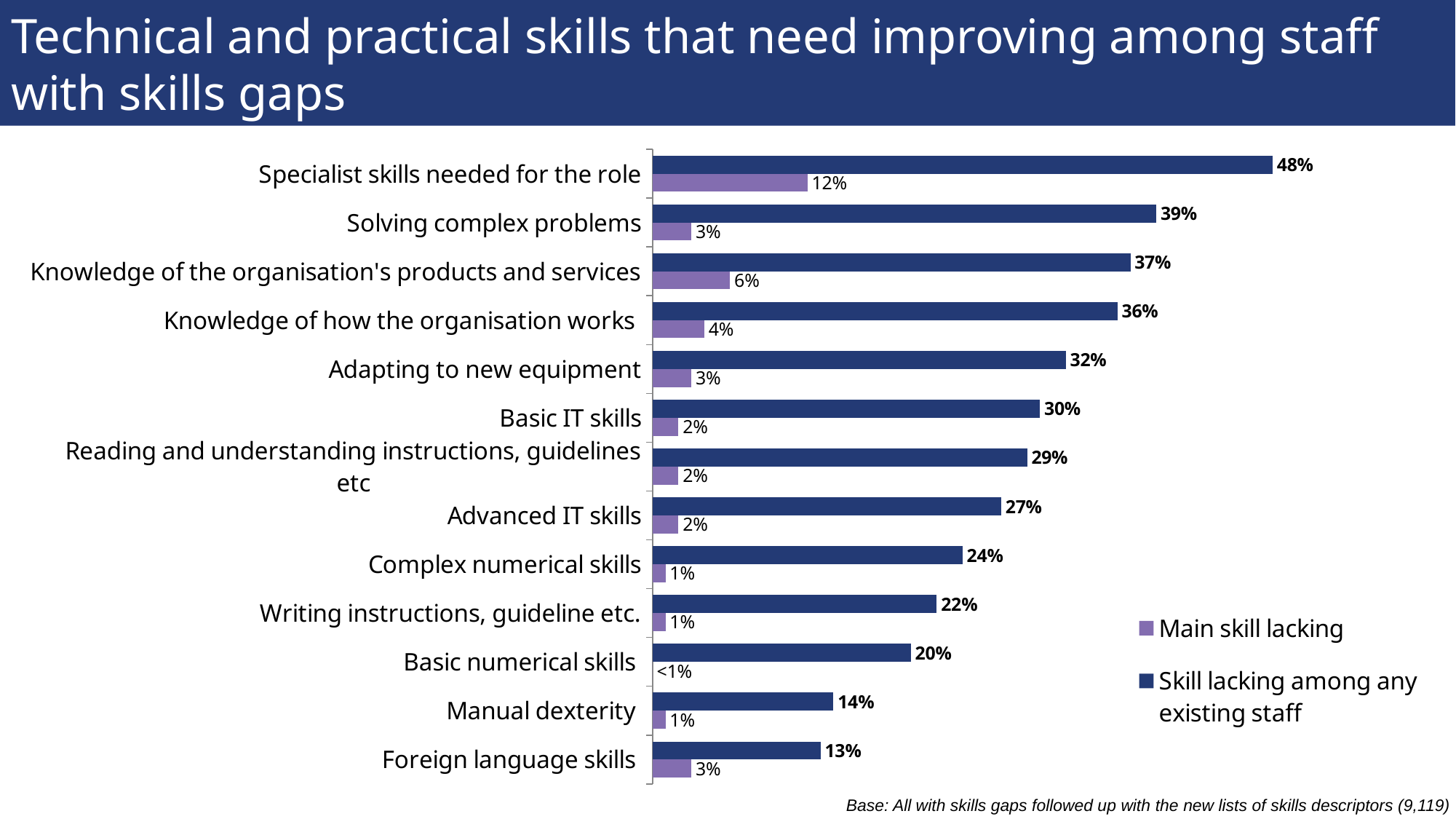
How many series does the legend list? 2 Which skill has the highest 'Main skill lacking' percentage? Specialist skills needed for the role How many skill categories are shown on the chart? 13 What is the 'Main skill lacking' value for Knowledge of the organisation's products and services? 6% Which is larger: the 'Skill lacking among any existing staff' value for Basic IT skills or for Advanced IT skills? Basic IT skills Which skill has the lowest 'Skill lacking among any existing staff' percentage? Foreign language skills What is the difference between the 'Skill lacking among any existing staff' values for Solving complex problems and Adapting to new equipment? 7% Which skill has the highest 'Skill lacking among any existing staff' percentage? Specialist skills needed for the role What is the 'Main skill lacking' value shown for Basic numerical skills? <1% What is the 'Skill lacking among any existing staff' value for Basic numerical skills? 20% What percentage is shown for 'Skill lacking among any existing staff' for Specialist skills needed for the role? 48% What type of chart is shown on the slide? Bar chart